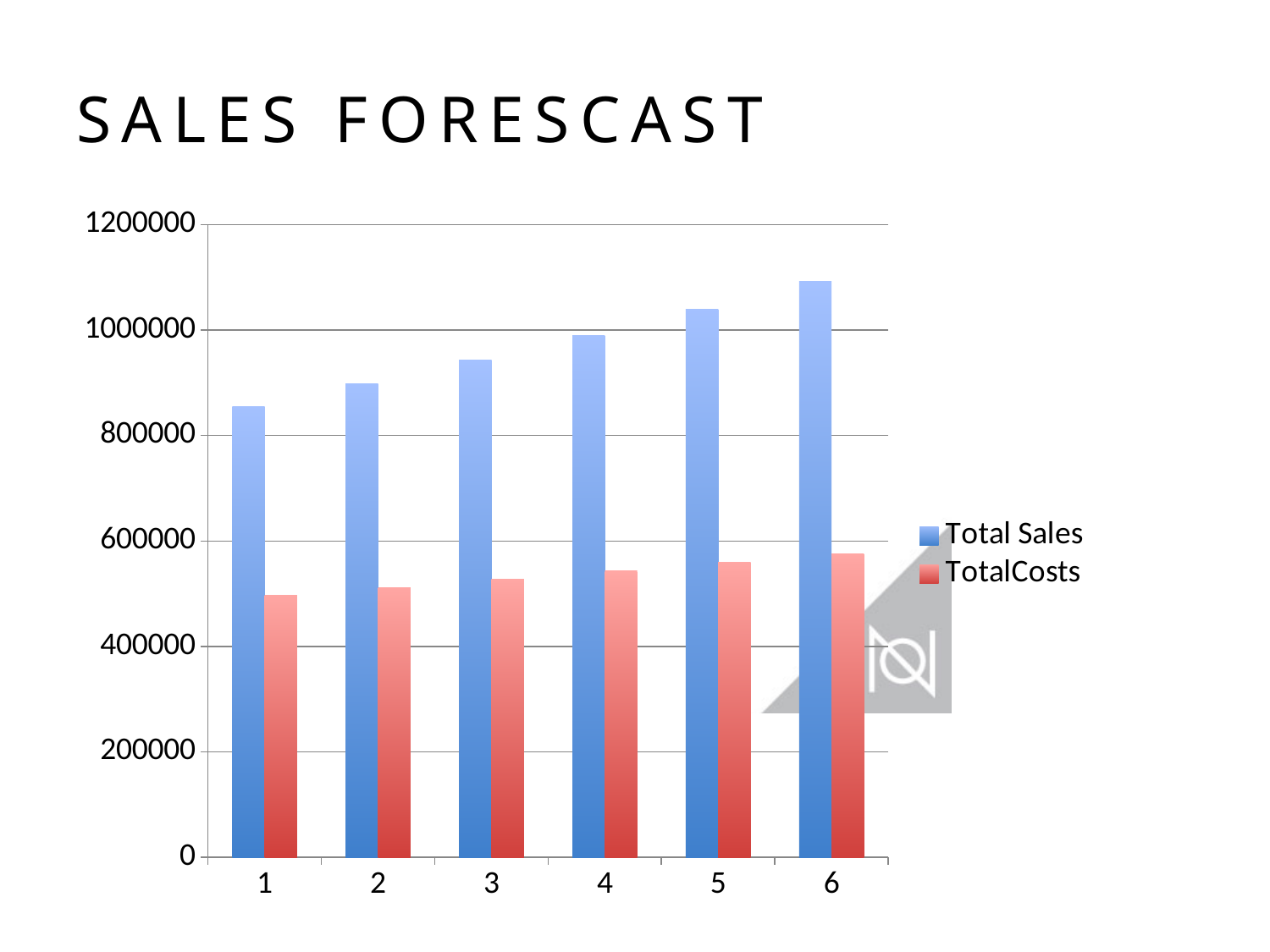
Is the Total Sales value for category 1 greater or less than 800000? greater How many series does the legend list? 2 Which category has the lowest TotalCosts value? 1 For category 3, which is larger: Total Sales or TotalCosts? Total Sales How many categories are shown on the x axis? 6 Do the Total Sales values rise or fall from category 1 to category 6? Rise Which category has the highest Total Sales value? 6 What kind of chart is shown on the slide? Bar chart What is the title of the slide? SALES FORESCAST Which category has the lowest Total Sales value? 1 Is the Total Sales value for category 6 greater or less than 1000000? greater Is the TotalCosts value for category 6 greater or less than 600000? less